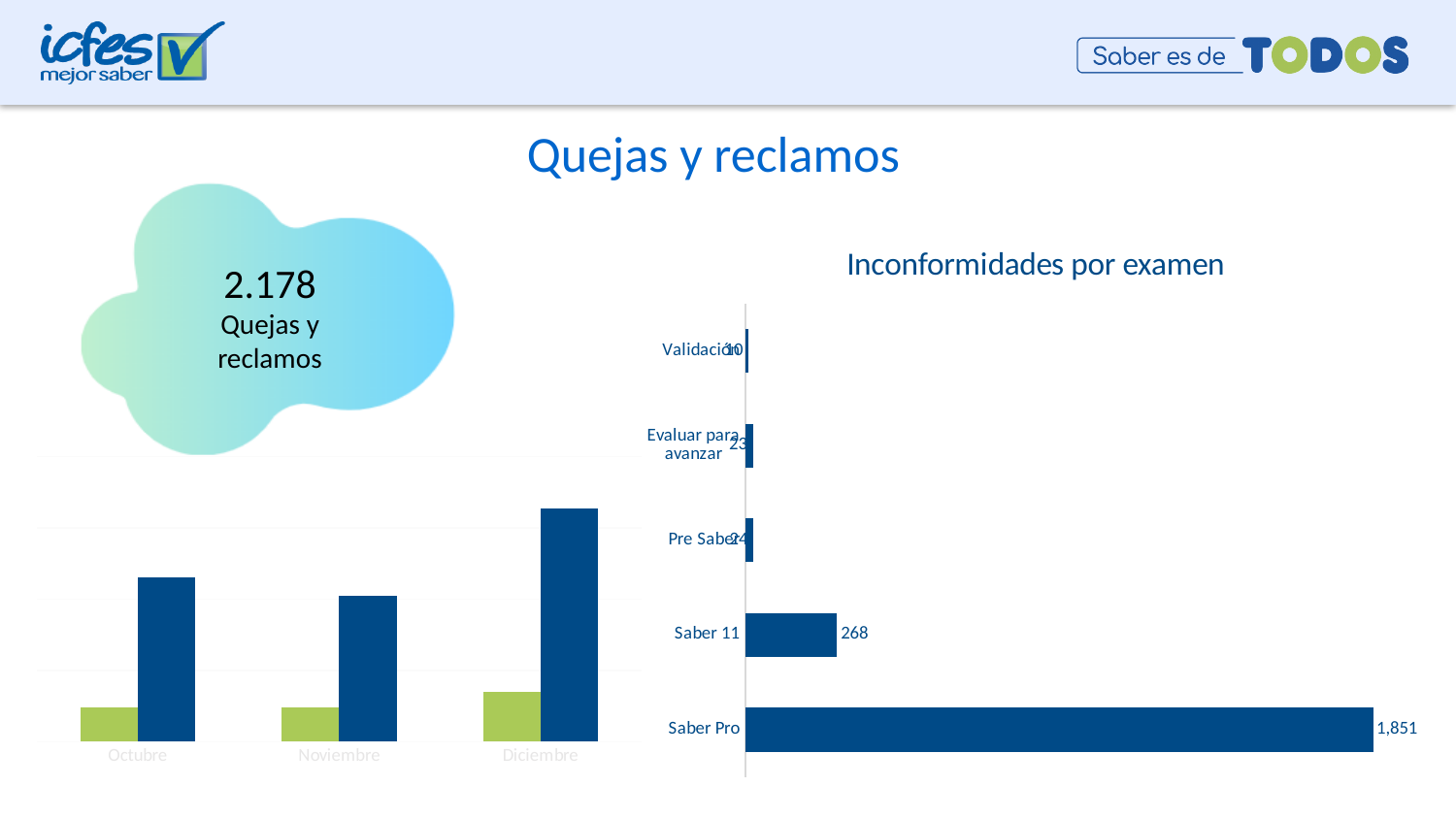
In the 'Inconformidades por examen' chart, what is the difference between Saber Pro and Saber 11? 1,583 In the 'Inconformidades por examen' chart, which exam has the highest number of inconformidades? Saber Pro What is the total number of 'Quejas y reclamos' shown in the cloud shape on the slide? 2.178 In the 'Inconformidades por examen' chart, what is the value for Evaluar para avanzar? 23 What type of chart is 'Inconformidades por examen'? Bar chart In the 'Inconformidades por examen' chart, which is larger, Saber 11 or Pre Saber? Saber 11 In the 'Inconformidades por examen' chart, which exam has the lowest number of inconformidades? Validación In the chart on the left of the slide, which month has the tallest dark blue bar? Diciembre In the chart on the left of the slide, how many months are shown on the x axis? 3 How many exam categories are shown in the 'Inconformidades por examen' chart? 5 In the 'Inconformidades por examen' chart, what is the value for Saber Pro? 1,851 In the 'Inconformidades por examen' chart, what is the value for Saber 11? 268